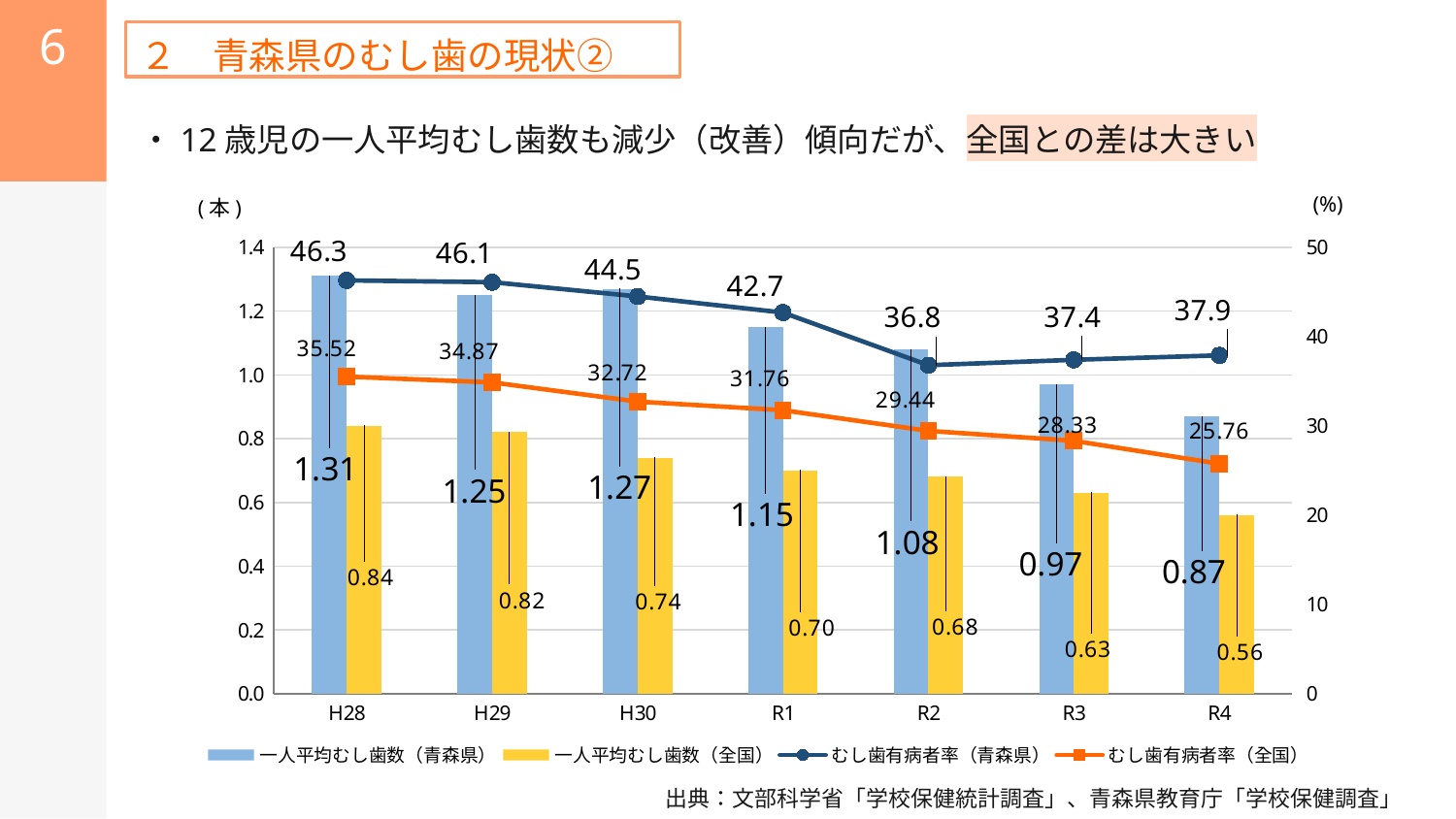
Which is larger for R3: むし歯有病者率（青森県） or むし歯有病者率（全国）? むし歯有病者率（青森県） In which year is むし歯有病者率（青森県） the highest? H28 Does むし歯有病者率（全国） rise or fall from H28 to R4? Fall What is the difference between 一人平均むし歯数（青森県） and 一人平均むし歯数（全国） for R1? 0.45 What is the value of むし歯有病者率（全国） for H30? 32.72 What is the value of 一人平均むし歯数（青森県） for H28? 1.31 How many series does the legend list? 4 What is the value of むし歯有病者率（青森県） for R2? 36.8 In which year is 一人平均むし歯数（青森県） the lowest? R4 What kind of chart is this? Combined bar and line chart What is the value of 一人平均むし歯数（全国） for R4? 0.56 How many years are shown on the x axis? 7